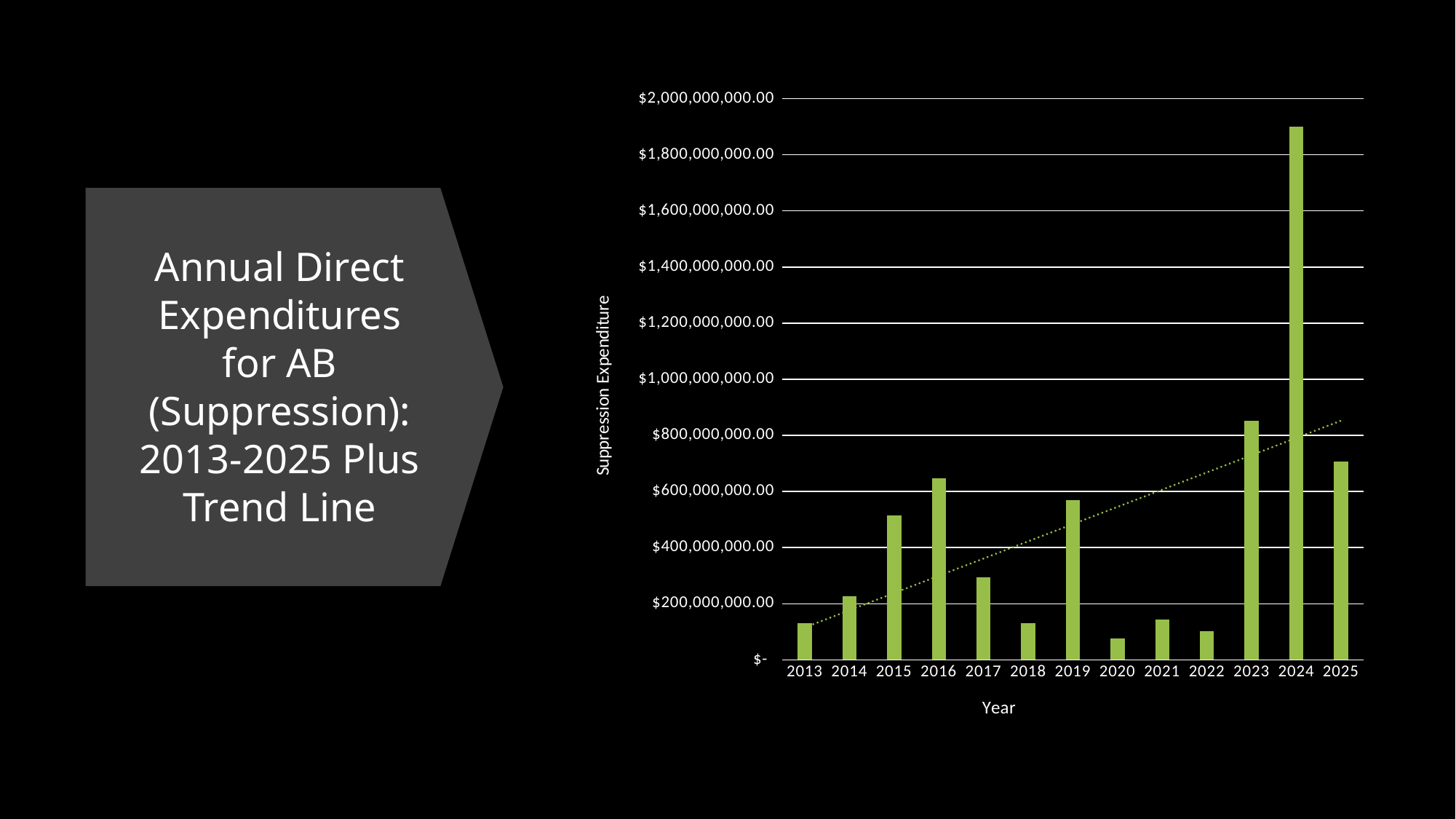
Which year has the highest suppression expenditure? 2024 Is the value for 2016 greater or less than $600,000,000.00? greater What kind of chart is shown on the slide? Bar chart Which is larger, the value for 2019 or the value for 2017? 2019 Does the dotted trend line rise or fall from 2013 to 2025? Rises Is the value for 2024 greater or less than $1,800,000,000.00? greater Is the value for 2020 greater or less than $200,000,000.00? less Which year has the lowest suppression expenditure? 2020 How many years are plotted on the x axis? 13 What is the label on the vertical axis? Suppression Expenditure